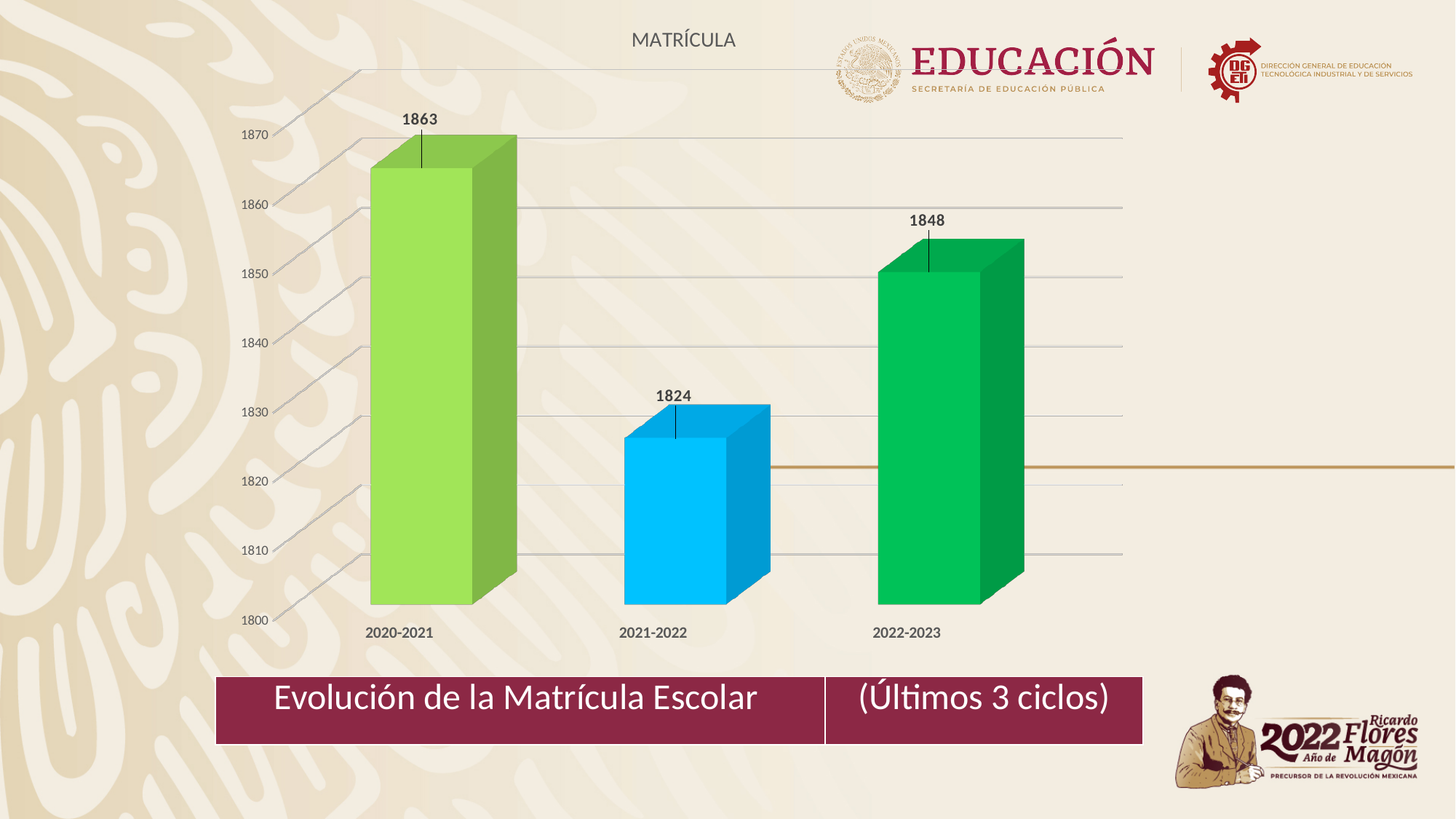
What is the difference between the values for 2020-2021 and 2021-2022? 39 What is the title of the chart? MATRÍCULA What kind of chart is shown on the slide? bar chart What is the value for 2021-2022? 1824 Which school cycle has the highest value? 2020-2021 How many school cycles are shown on the chart? 3 What is the value for 2020-2021? 1863 Which school cycle has the lowest value? 2021-2022 What is the value for 2022-2023? 1848 Which is larger, the value for 2022-2023 or the value for 2021-2022? 2022-2023 What is the difference between the values for 2022-2023 and 2021-2022? 24 Is the value for 2021-2022 greater or less than 1830? less